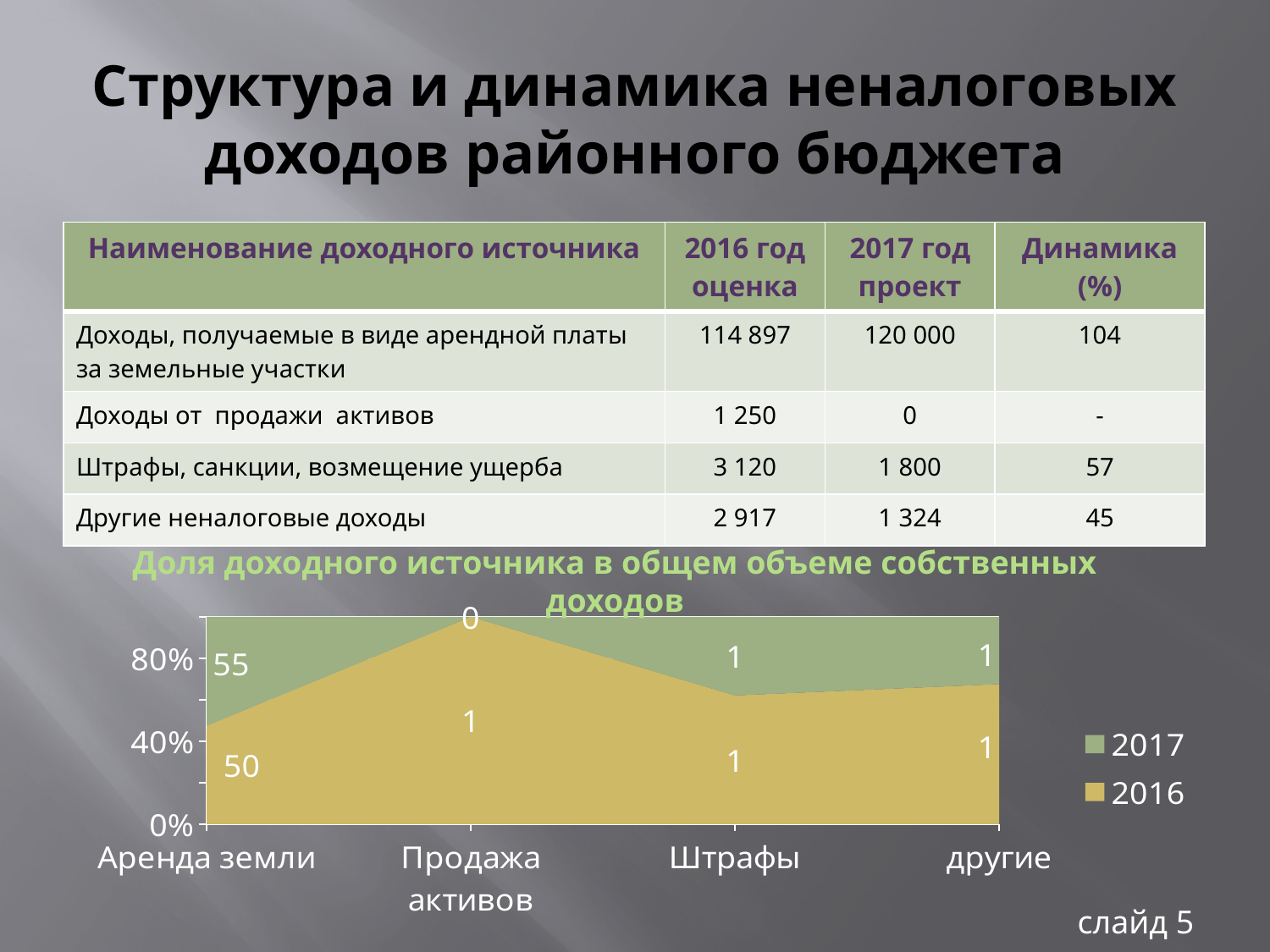
How many categories are shown on the x axis of the chart? 4 What is the difference between the 2017 and 2016 data labels at "Аренда земли"? 5 What is the data label for the 2016 series at "Продажа активов"? 1 What is the data label for the 2016 series at "Аренда земли"? 50 What is the data label for the 2017 series at "Продажа активов"? 0 At "Аренда земли", which series has the larger data label, 2016 or 2017? 2017 What is the data label for the 2016 series at "Штрафы"? 1 How many series does the chart legend list? 2 What is the data label for the 2017 series at "Аренда земли"? 55 What kind of chart is shown under the title "Доля доходного источника в общем объеме собственных доходов"? area chart Which series are listed in the chart legend? 2017 and 2016 Which category has the highest data label for the 2017 series? Аренда земли